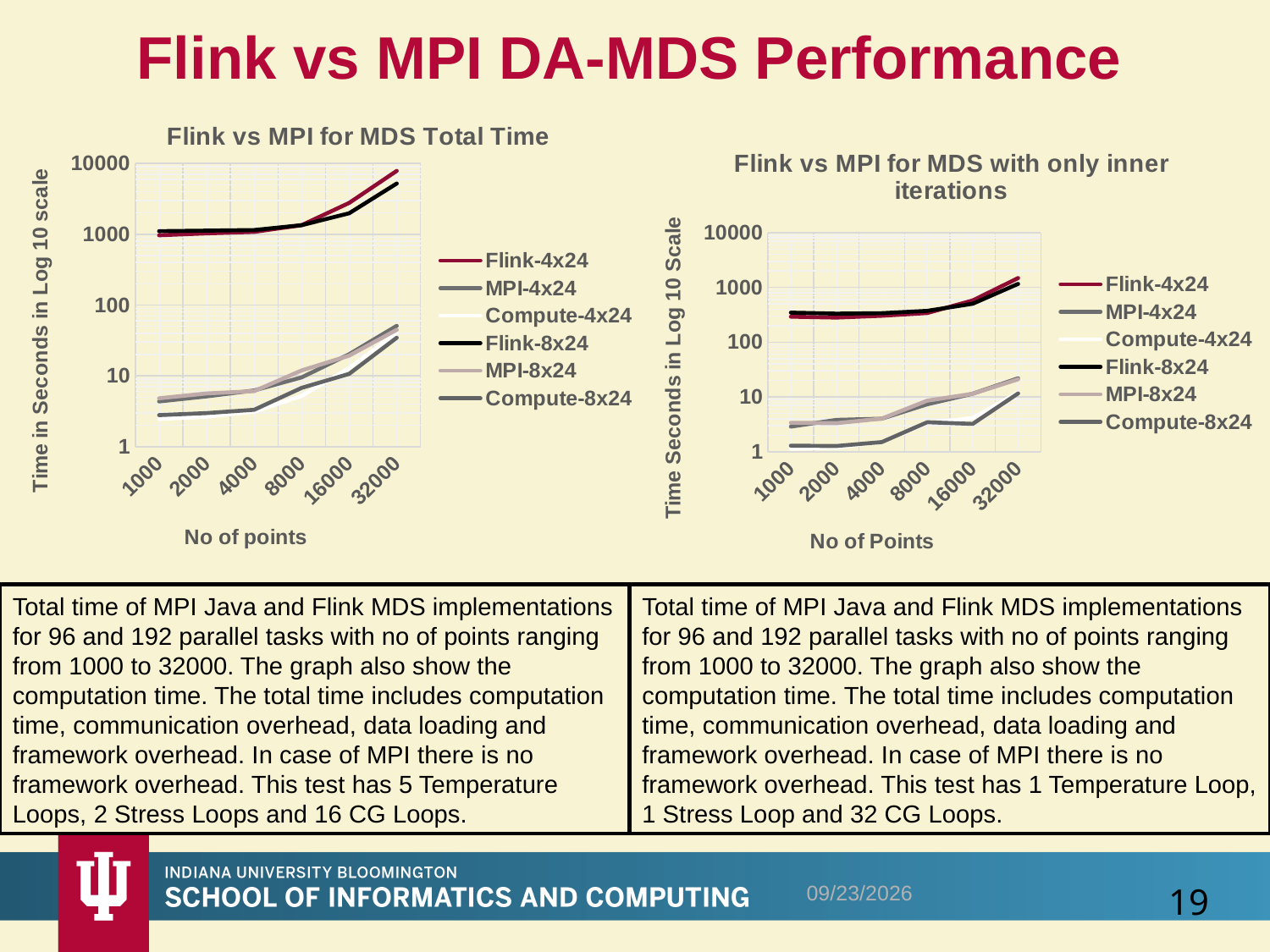
In the 'Flink vs MPI for MDS Total Time' chart, does the Flink-4x24 series rise or fall as the number of points increases? rise In the 'Flink vs MPI for MDS Total Time' chart, which is larger at 32000 points: Flink-4x24 or Compute-8x24? Flink-4x24 How many points along the x axis does the 'Flink vs MPI for MDS Total Time' chart plot for each series? 6 How many series does the legend of the 'Flink vs MPI for MDS with only inner iterations' chart list? 6 In the 'Flink vs MPI for MDS with only inner iterations' chart, is the value for Flink-4x24 at 32000 points greater or less than 1000? greater What is the x-axis label of the 'Flink vs MPI for MDS Total Time' chart? No of points In the 'Flink vs MPI for MDS with only inner iterations' chart, is the value for Flink-8x24 at 1000 points greater or less than 100? greater How many series does the legend of the 'Flink vs MPI for MDS Total Time' chart list? 6 What kind of chart is the 'Flink vs MPI for MDS Total Time' chart? line chart In the 'Flink vs MPI for MDS Total Time' chart, is the value for Compute-8x24 at 1000 points greater or less than 10? less What is the title of the chart on the right side of the slide? Flink vs MPI for MDS with only inner iterations